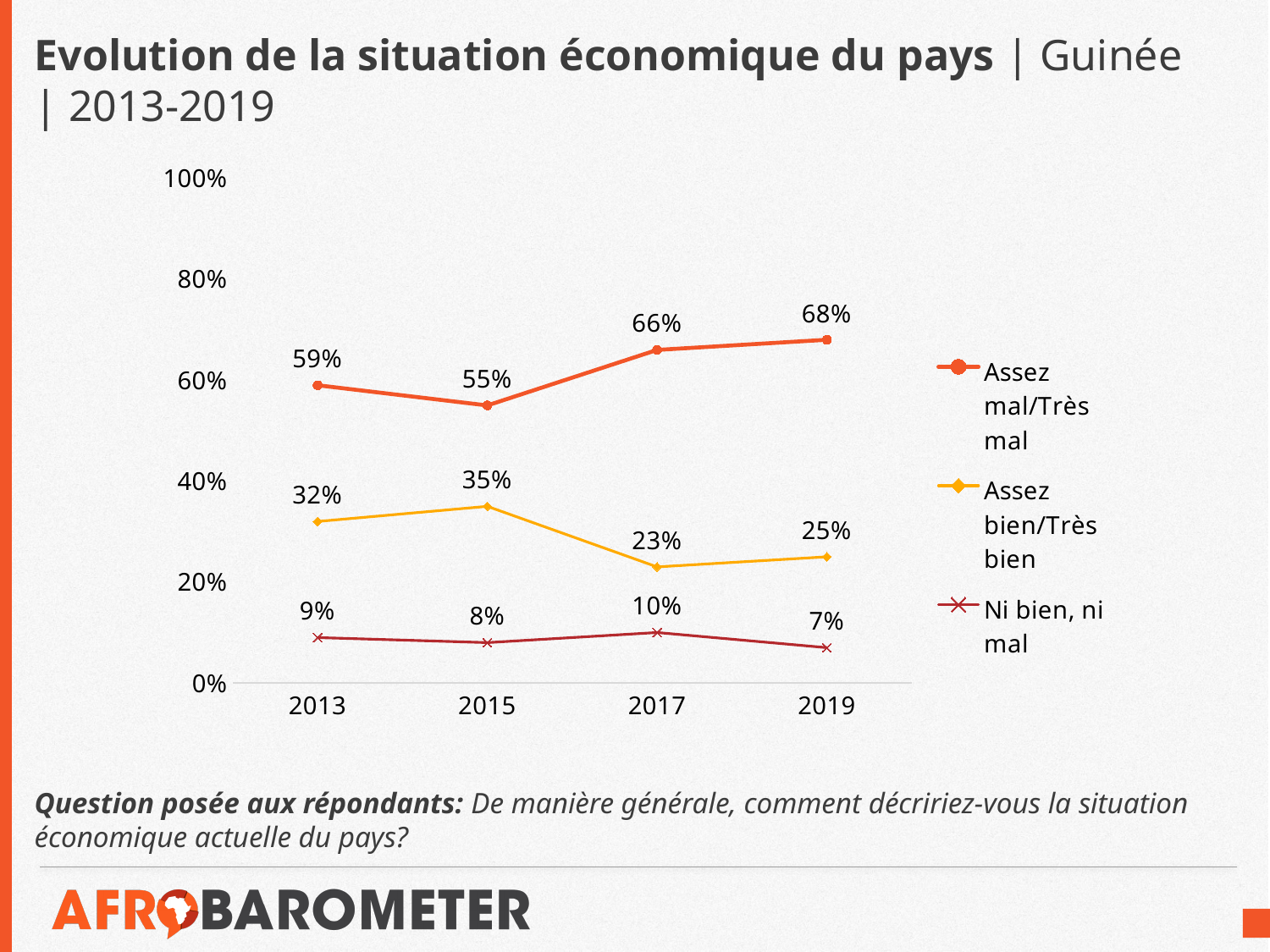
How many years are plotted on the x axis? 4 What is the value for "Assez mal/Très mal" in 2019? 68% Which is larger: the "Assez bien/Très bien" value in 2013 or in 2015? 2015 How many series does the legend list? 3 Does the "Assez mal/Très mal" series rise or fall between 2015 and 2019? rise What is the value for "Ni bien, ni mal" in 2017? 10% What is the difference between the "Assez mal/Très mal" value in 2019 and in 2013? 9% In which year is the "Assez bien/Très bien" series at its lowest? 2017 In which year is the "Assez mal/Très mal" series at its highest? 2019 Which series is shown with a red line and circle markers? Assez mal/Très mal What kind of chart is shown on the slide? line chart What is the value for "Assez bien/Très bien" in 2015? 35%